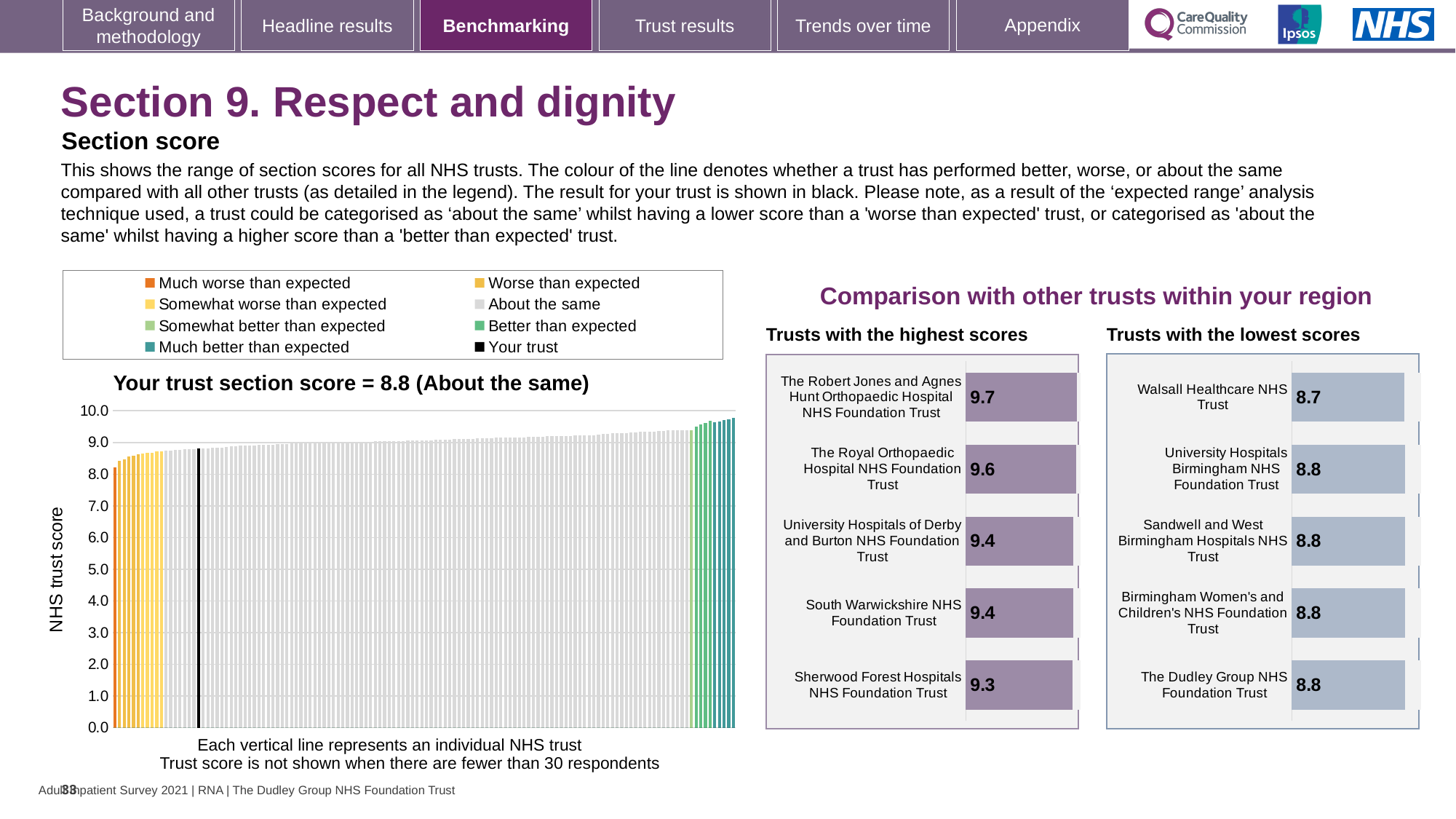
In the 'Trusts with the lowest scores' chart, which has the larger score: Walsall Healthcare NHS Trust or Sandwell and West Birmingham Hospitals NHS Trust? Sandwell and West Birmingham Hospitals NHS Trust In the 'Trusts with the highest scores' chart, what is the difference between the scores of The Robert Jones and Agnes Hunt Orthopaedic Hospital NHS Foundation Trust and Sherwood Forest Hospitals NHS Foundation Trust? 0.4 In the 'Trusts with the highest scores' chart, which trust has the lowest score? Sherwood Forest Hospitals NHS Foundation Trust In the 'Trusts with the lowest scores' chart, which trust has the lowest score? Walsall Healthcare NHS Trust In the 'Trusts with the highest scores' chart, how many trusts are shown? 5 How many entries does the legend above the large chart list? 8 What is the y-axis label of the large chart of all NHS trusts? NHS trust score In the 'Trusts with the highest scores' chart, what is the score for The Robert Jones and Agnes Hunt Orthopaedic Hospital NHS Foundation Trust? 9.7 According to the large chart's title, what is your trust's section score? 8.8 What kind of chart is the large chart titled 'Your trust section score = 8.8 (About the same)'? bar chart In the 'Trusts with the lowest scores' chart, what is the score for The Dudley Group NHS Foundation Trust? 8.8 In the large chart of all NHS trusts, do the bars rise or fall from left to right? rise